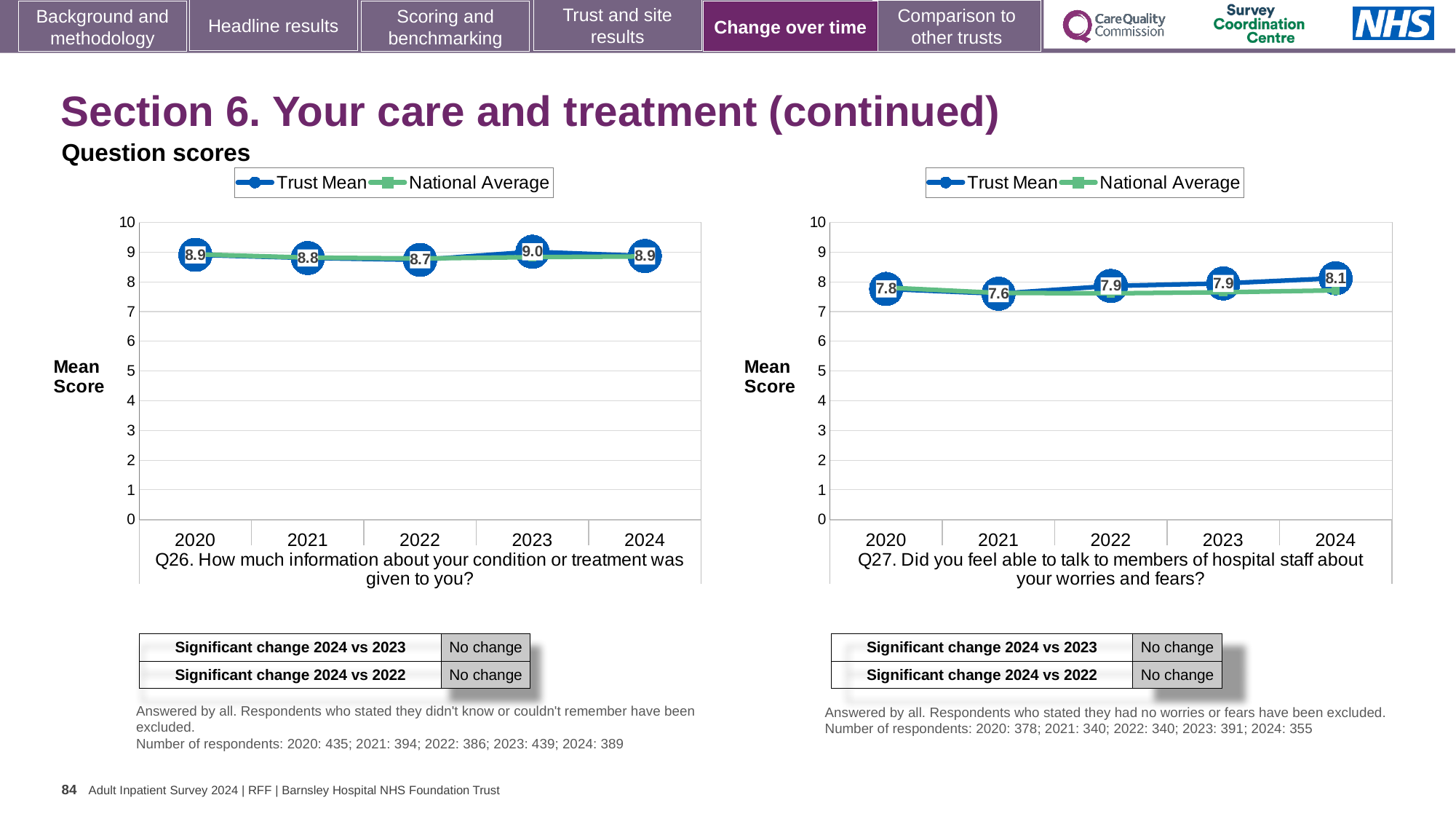
On the Q26 chart, what is the Trust Mean score for 2022? 8.7 What type of chart is used for Q27? Line chart How many series does the legend of the Q27 chart list? 2 On the Q26 chart, which year has the highest Trust Mean score? 2023 On the Q27 chart, what is the Trust Mean score for 2024? 8.1 On the Q26 chart, what is the Trust Mean score for 2023? 9.0 How many years are plotted on the Q26 chart? 5 On the Q27 chart, which year has the lowest Trust Mean score? 2021 On the Q27 chart, what is the Trust Mean score for 2021? 7.6 On the Q27 chart, what is the difference between the Trust Mean scores for 2024 and 2021? 0.5 On the Q26 chart, is the Trust Mean score for 2020 or 2022 higher? 2020 On the Q27 chart, is the National Average value for 2024 greater or less than 9? less